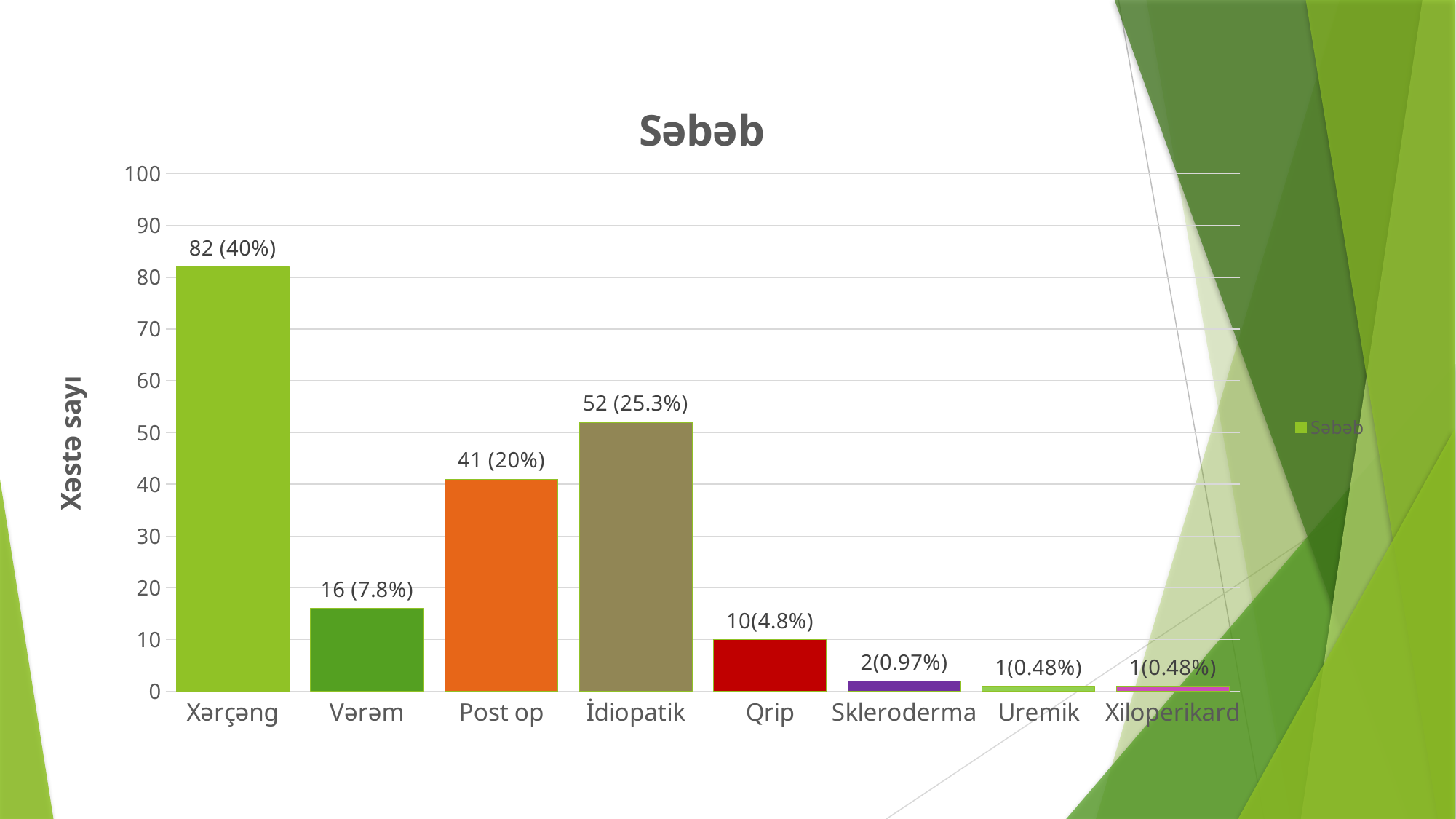
What type of chart is shown on the slide? bar chart What is the label of the y axis? Xəstə sayı What is the difference in patient count between Xərçəng and Post op? 41 What is the data label for İdiopatik? 52 (25.3%) Which category has the highest value? Xərçəng What is the data label for Xərçəng? 82 (40%) What is the data label for Qrip? 10(4.8%) Which category has the lowest value, Vərəm or Skleroderma? Skleroderma What is the title of the chart? Səbəb How many categories are shown on the x axis? 8 Which is larger, the value for Post op or the value for İdiopatik? İdiopatik How many series does the legend list? 1